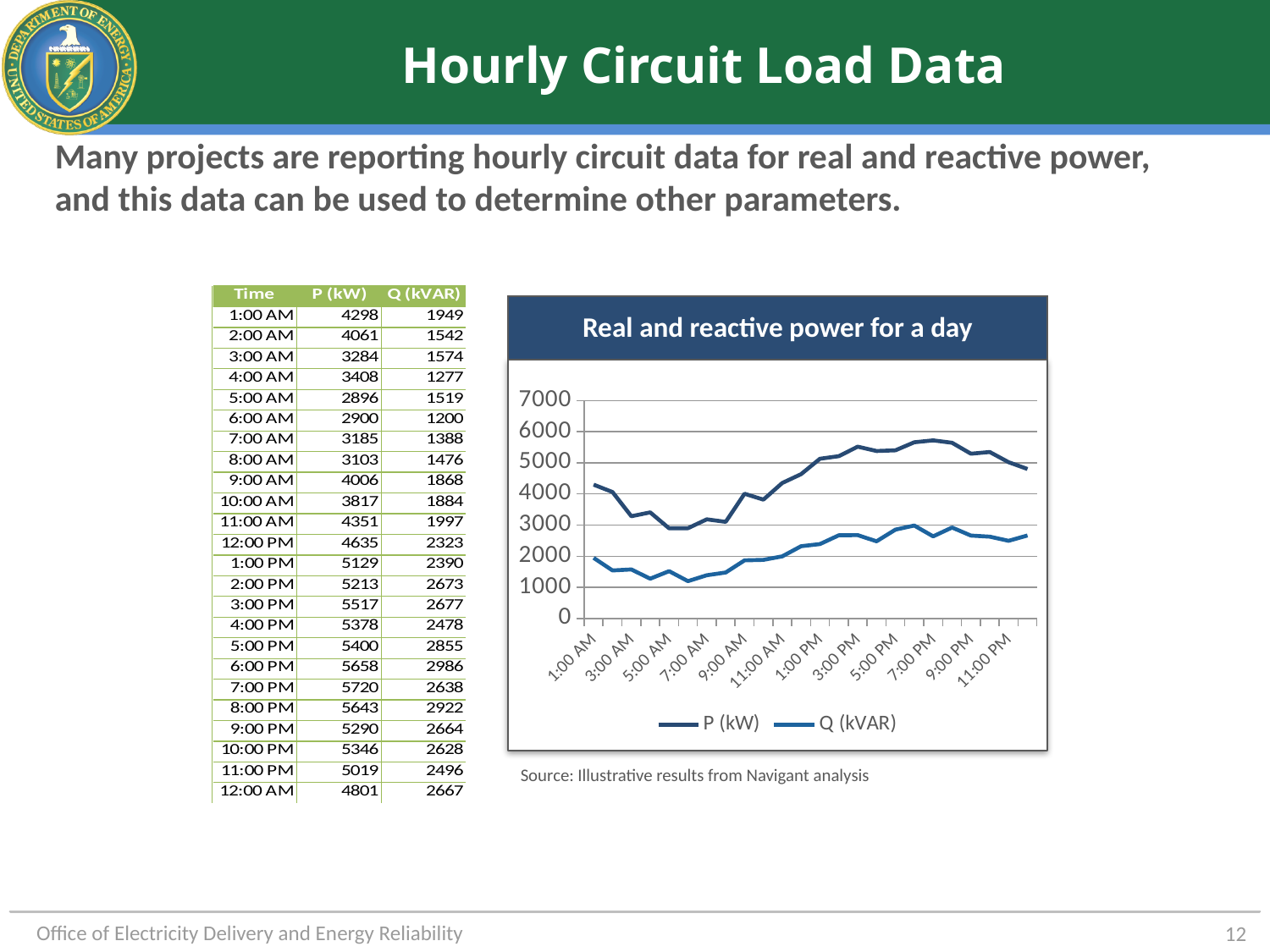
According to the table, what is the Q (kVAR) value at 6:00 PM? 2986 What is the title of the chart on the slide? Real and reactive power for a day How many series does the legend of the "Real and reactive power for a day" chart list? 2 According to the table, what is the P (kW) value at 1:00 AM? 4298 At which time does P (kW) reach its highest value, according to the table? 7:00 PM What type of chart is shown under the title "Real and reactive power for a day"? line chart In the chart, which series has the higher values across the day, P (kW) or Q (kVAR)? P (kW) Is the P (kW) value at 7:00 PM greater or less than 5000? greater What are the two series named in the legend of the chart? P (kW) and Q (kVAR) Does the P (kW) line generally rise or fall from 5:00 AM to 7:00 PM? rise Is the Q (kVAR) value at 1:00 AM greater or less than 3000? less What is the difference between P (kW) and Q (kVAR) at 12:00 PM, using the table values? 2312